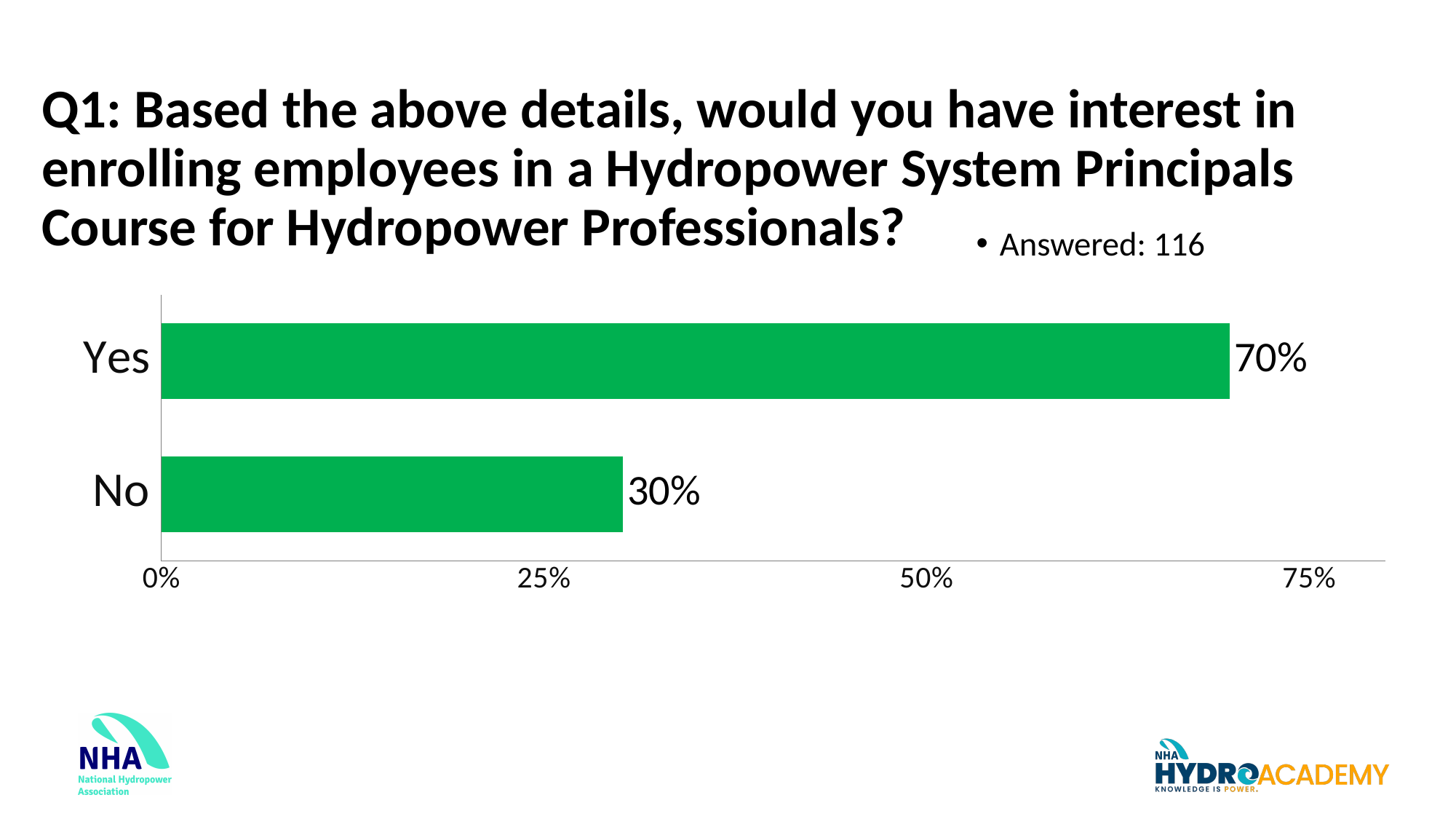
Is the value for No greater or less than 50%? less What kind of chart is shown on the slide? bar chart Which response has the highest value? Yes What percentage of respondents answered No? 30% How many people answered the question, according to the slide? 116 What percentage of respondents answered Yes? 70% Which response has the lowest value? No Is the value for Yes greater or less than 50%? greater What is the highest value labelled on the x axis? 75% What is the difference between the Yes and No percentages? 40% How many response categories are shown in the chart? 2 Which is larger, the value for Yes or the value for No? Yes